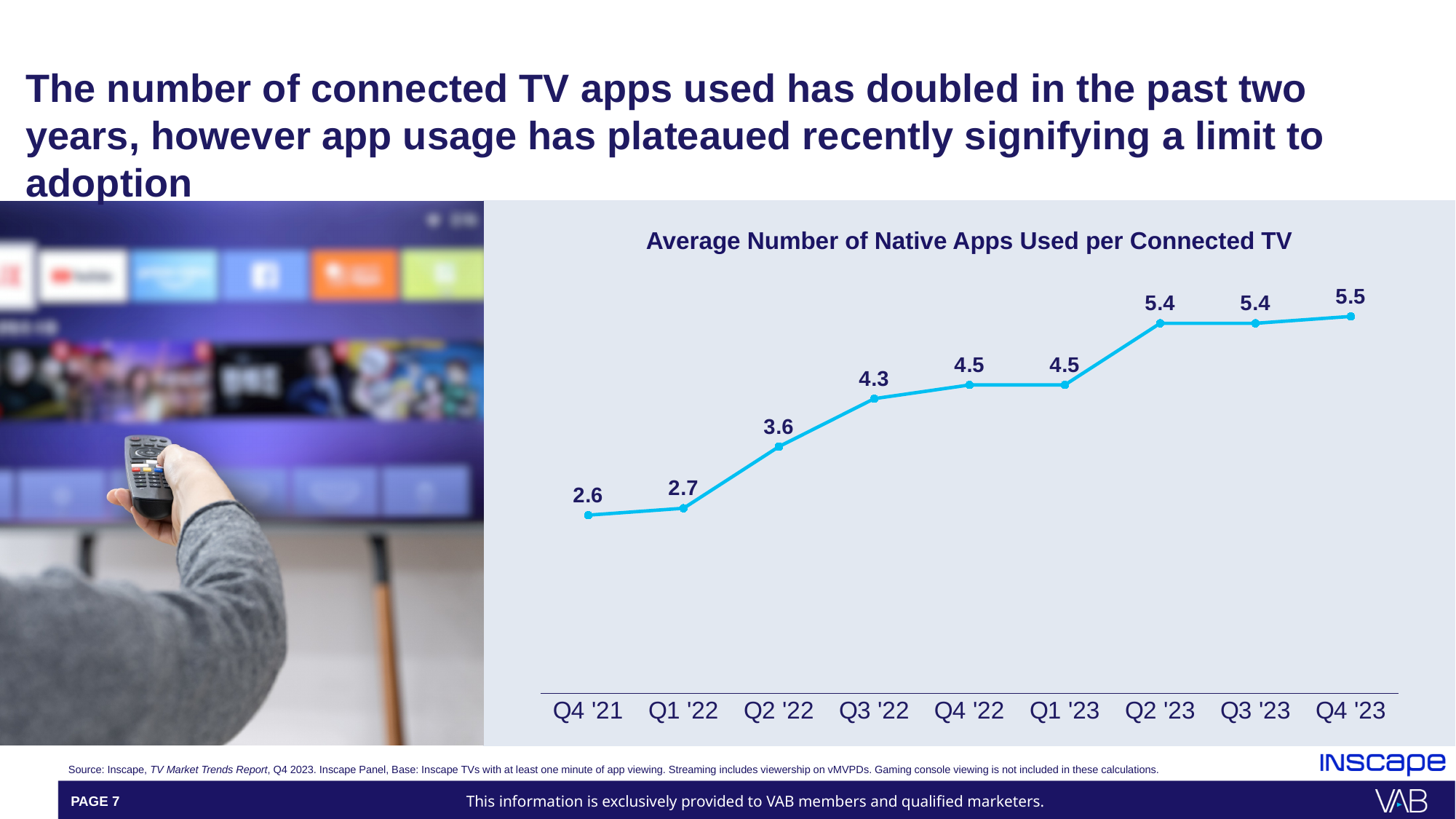
What is the difference between the values for Q2 '23 and Q1 '23? 0.9 What is the value for Q3 '22? 4.3 What is the difference between the values for Q4 '23 and Q4 '21? 2.9 Which quarter has the lowest average number of native apps used per connected TV? Q4 '21 Do the values generally rise or fall from Q4 '21 to Q4 '23? Rise What is the value for Q2 '22? 3.6 What is the value for Q4 '23? 5.5 Which quarter has the highest average number of native apps used per connected TV? Q4 '23 What is the average number of native apps used per connected TV in Q4 '21? 2.6 What kind of chart is shown on the slide? Line chart How many quarters are plotted on the chart? 9 Which is larger, the value for Q3 '22 or the value for Q2 '22? Q3 '22